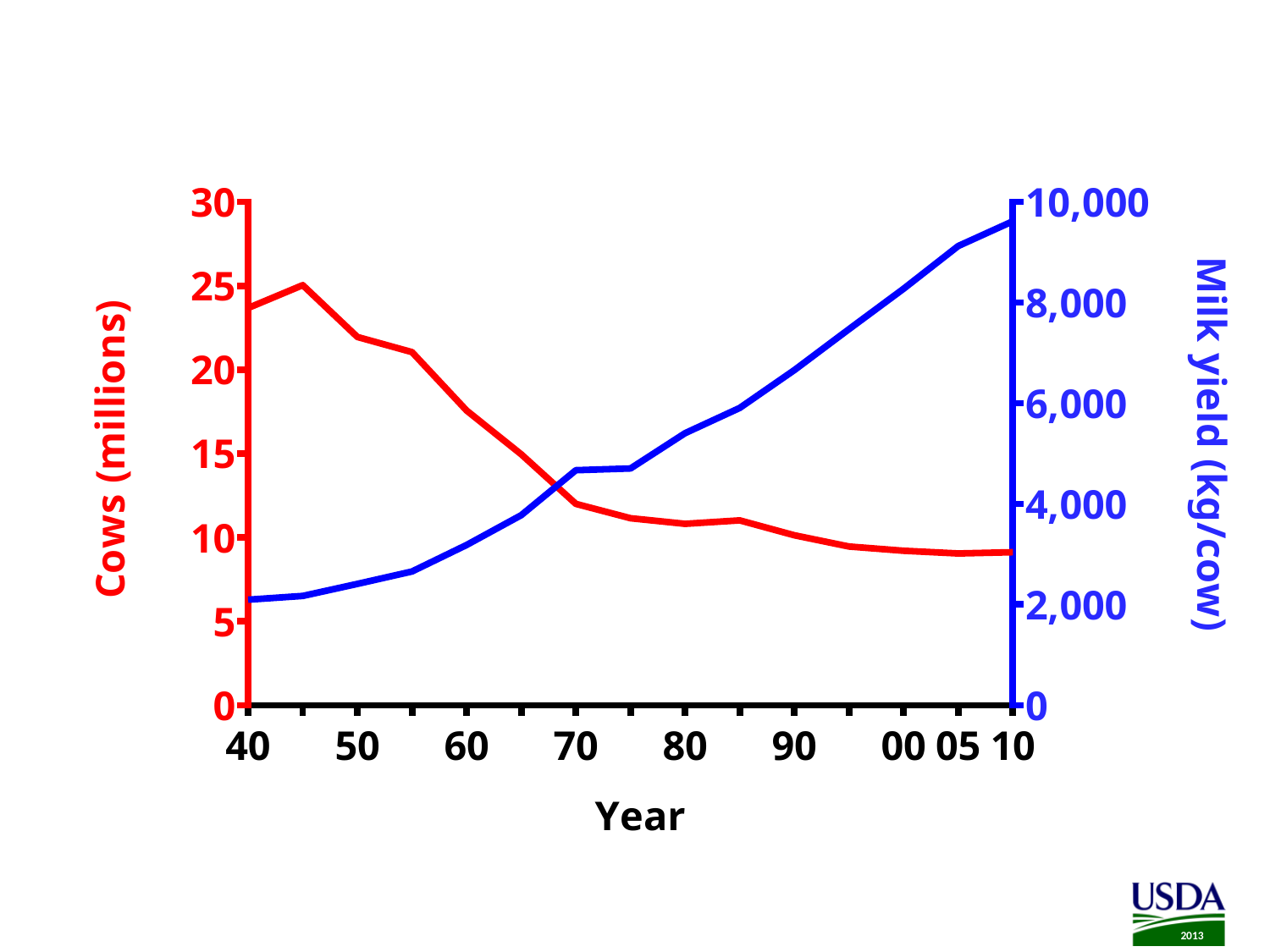
Is the value of Milk yield (kg/cow) in year 40 greater or less than 4,000? less In which year does the Milk yield (kg/cow) line have its lowest value? 40 What does the right (blue) vertical axis measure? Milk yield (kg/cow) Is the value of Cows (millions) in year 40 greater or less than 20? greater What kind of chart is shown on the slide? line chart Does the blue Milk yield (kg/cow) line generally rise or fall from 1940 to 2010? rise Is the value of Milk yield (kg/cow) in year 10 greater or less than 8,000? greater What does the left (red) vertical axis measure? Cows (millions) In which year does the Milk yield (kg/cow) line reach its highest value? 10 Does the red Cows (millions) line generally rise or fall from 1940 to 2010? fall Which year has the larger Cows (millions) value, 50 or 90? 50